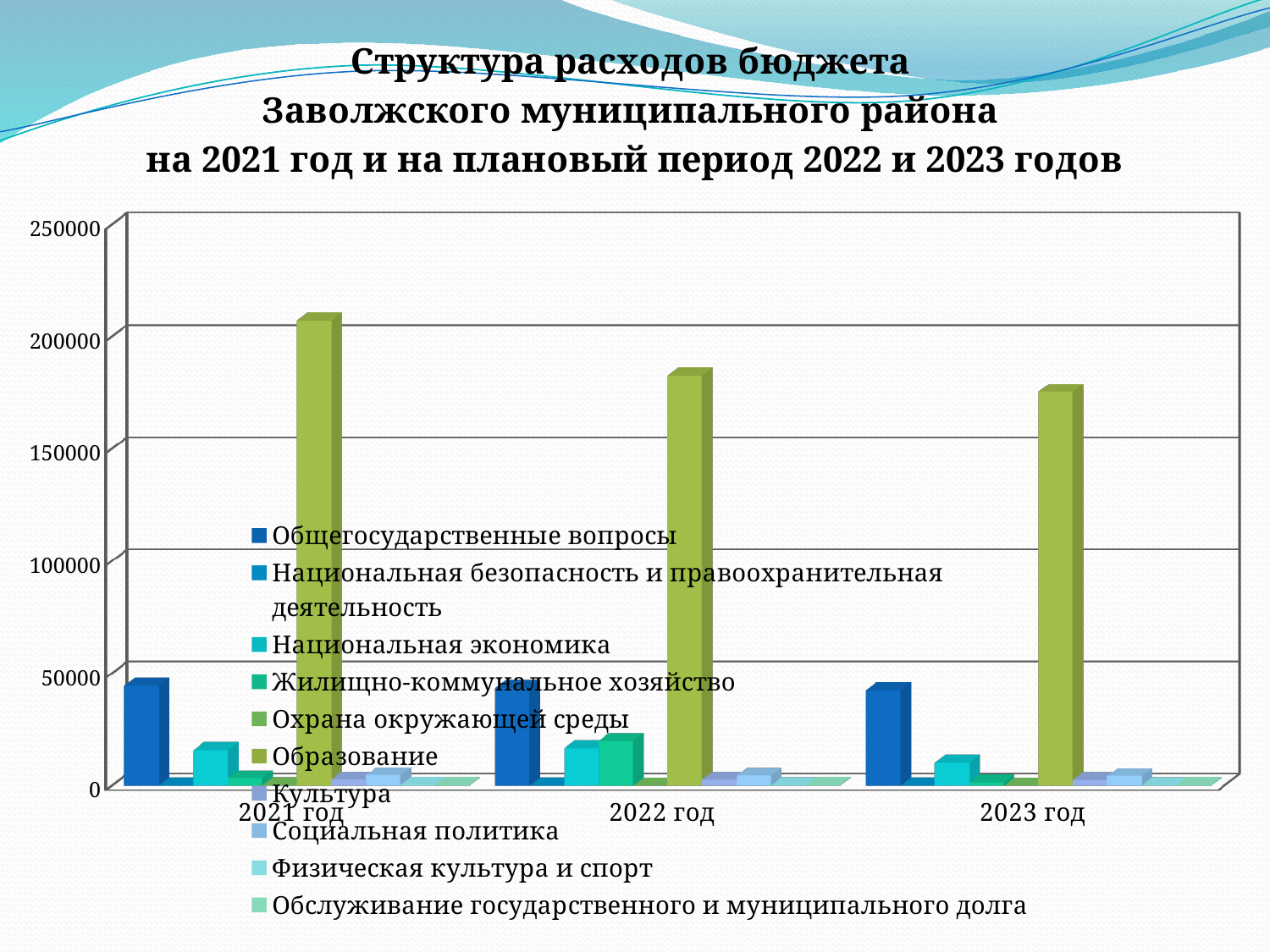
Which series has the tallest bar in 2022 год? Образование Which series is listed last in the legend? Обслуживание государственного и муниципального долга Does the value for Образование rise or fall from 2021 год to 2023 год? fall What is the first line of the slide title? Структура расходов бюджета Is the value for Образование in 2021 год greater or less than 150000? greater In which year is the bar for Образование the highest? 2021 год How many year categories are shown on the x axis? 3 Is the value for Образование in 2022 год greater or less than 200000? less How many series does the legend list? 10 Which is larger in 2021 год: Образование or Общегосударственные вопросы? Образование Is the value for Общегосударственные вопросы in 2021 год greater or less than 100000? less What kind of chart is shown on the slide? bar chart